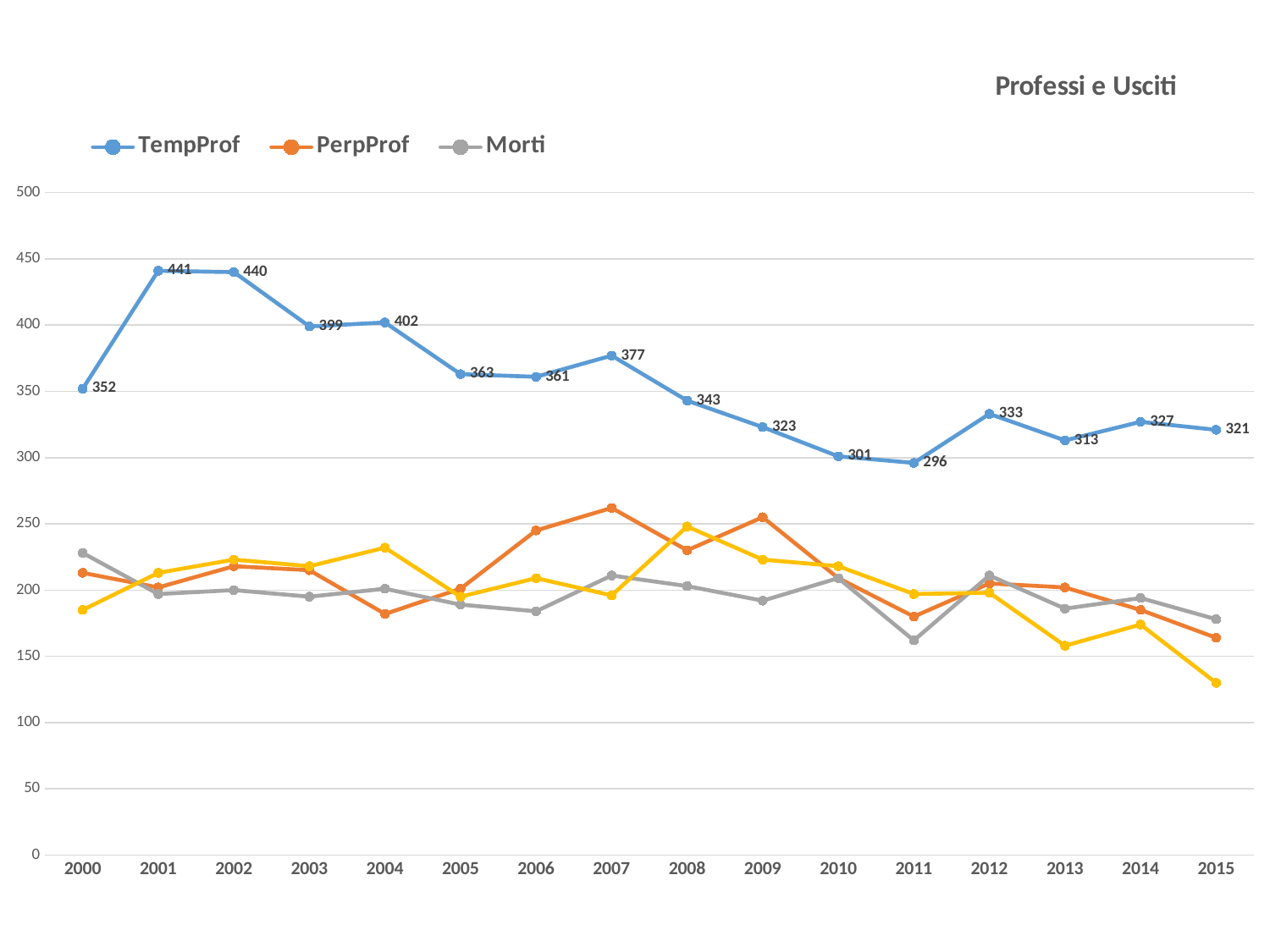
Between 2002 and 2011, does the TempProf line generally rise or fall? fall In which year is the TempProf value lowest? 2011 In which year is the TempProf value highest? 2001 How many years are shown on the x axis? 16 What type of chart is shown on the slide? line chart What is the title of the chart? Professi e Usciti How many series does the legend list? 3 Which is larger, the TempProf value for 2007 or for 2008? 2007 What is the TempProf value for 2007? 377 What is the TempProf value for 2015? 321 What is the difference between the TempProf values for 2001 and 2000? 89 Is the PerpProf value for 2007 greater or less than 250? greater